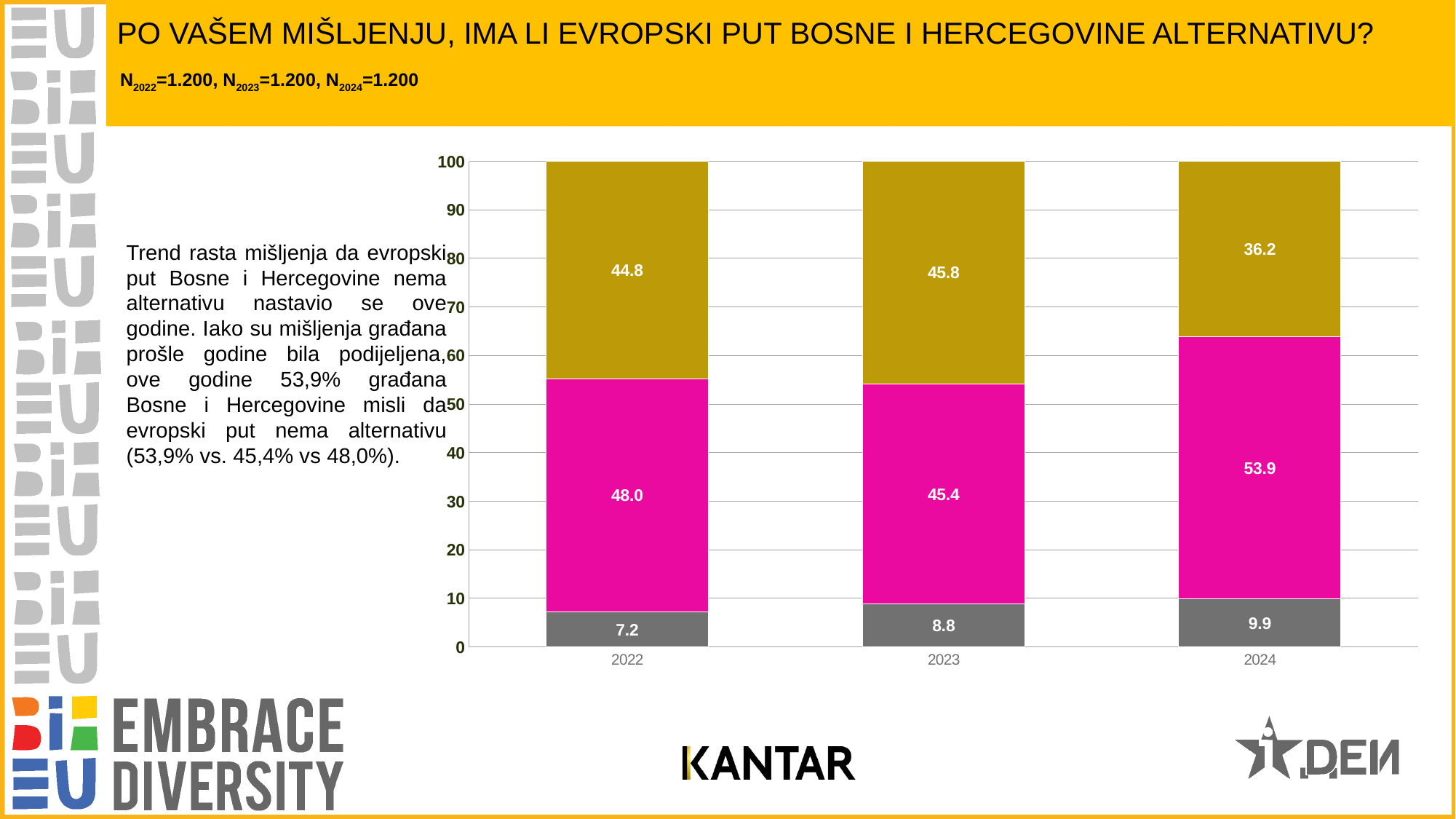
In which year is the grey segment the smallest? 2022 In which year is the pink segment the largest? 2024 What is the value of the grey segment for 2022? 7.2 How many years are shown on the x axis of the chart? 3 What is the difference between the gold segment in 2023 and in 2024? 9.6 What is the total of the stacked bar for 2022? 100.0 Which is larger, the gold segment in 2022 or in 2024? 2022 What is the value of the gold segment for 2023? 45.8 By how much did the pink segment increase from 2023 to 2024? 8.5 What is the value of the pink segment for 2024? 53.9 Does the grey segment rise or fall from 2022 to 2024? Rise What kind of chart is shown on the slide? Stacked bar chart